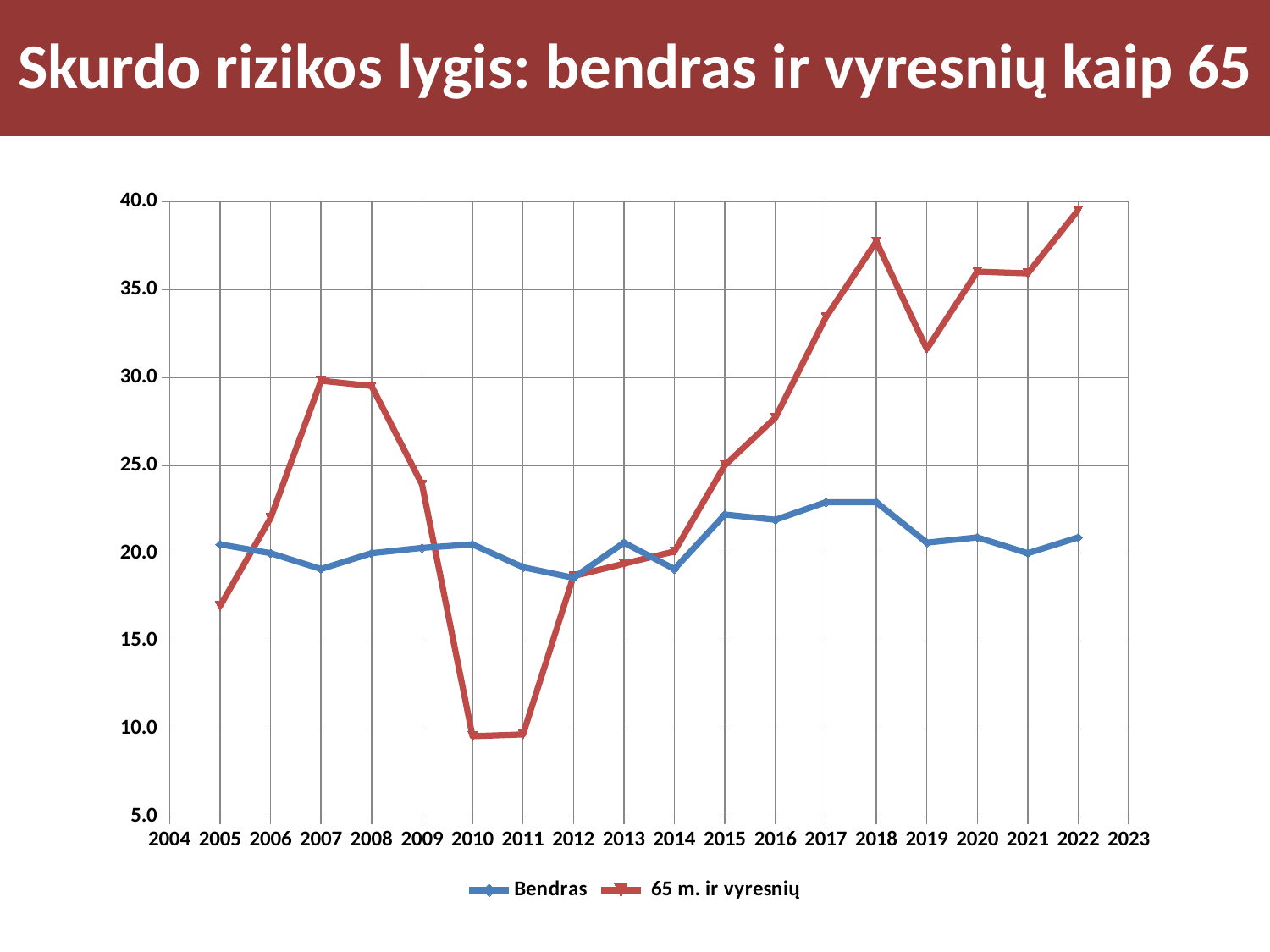
What kind of chart is shown on the slide? line chart Does the '65 m. ir vyresnių' series rise or fall from 2019 to 2022? rise How many years have plotted data points for each series? 18 In which year does the '65 m. ir vyresnių' series reach its highest value? 2022 Is the value for '65 m. ir vyresnių' in 2010 greater or less than 10? less Is the value for '65 m. ir vyresnių' in 2005 greater or less than 20? less How many series does the legend list? 2 Is the value for 'Bendras' in 2015 greater or less than 20? greater In 2018, which series has the larger value, 'Bendras' or '65 m. ir vyresnių'? 65 m. ir vyresnių In 2010, which series has the larger value, 'Bendras' or '65 m. ir vyresnių'? Bendras What is the title of the slide? Skurdo rizikos lygis: bendras ir vyresnių kaip 65